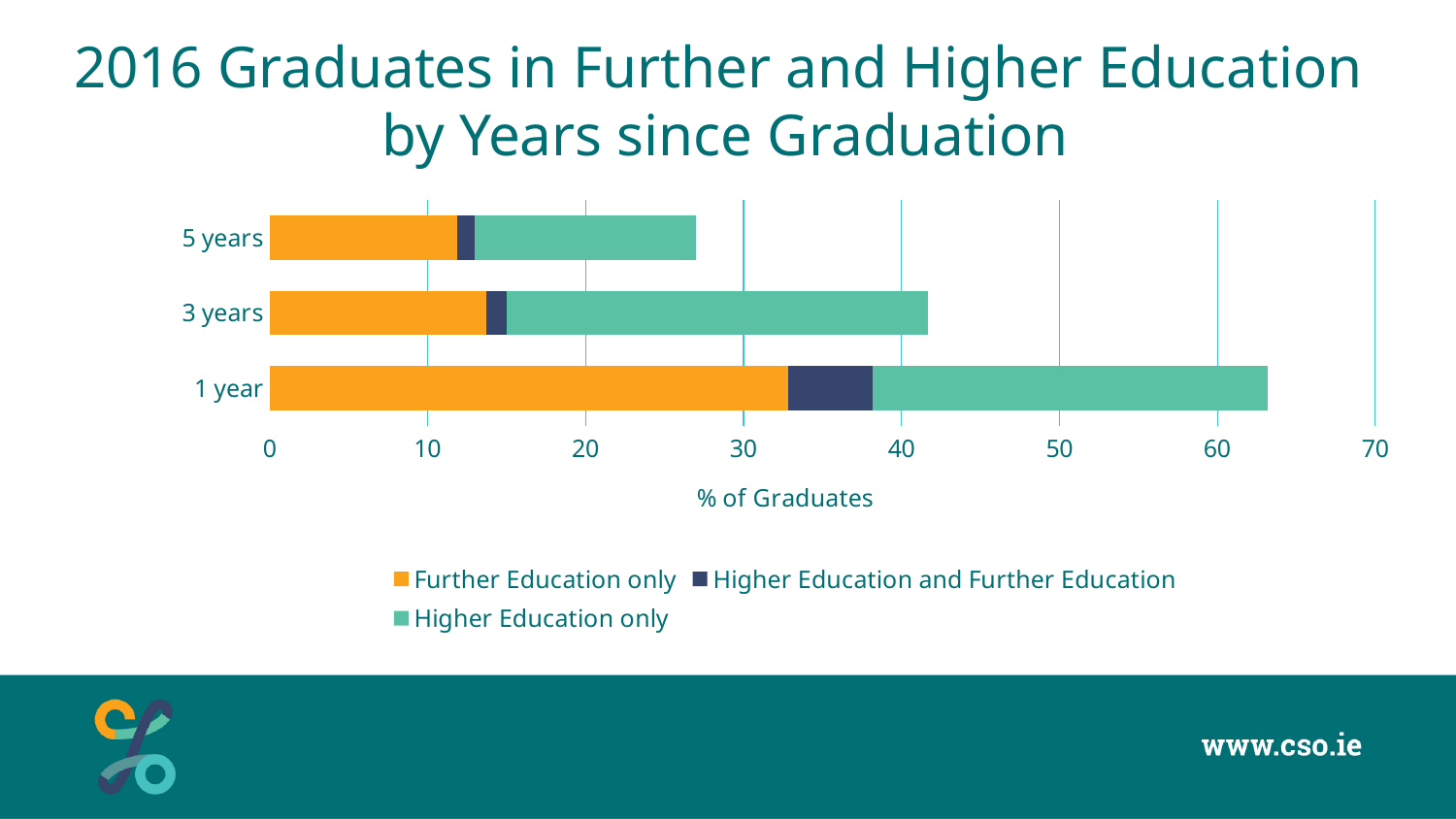
Which category has the longest total bar? 1 year Is the total value for 1 year greater or less than 60? greater Is the Further Education only value for 5 years greater or less than 10? greater What is the label on the horizontal axis? % of Graduates Is the Further Education only value for 1 year greater or less than 30? greater As the years since graduation increase from 1 year to 5 years, does the total percentage of graduates in education rise or fall? fall What kind of chart is shown on the slide? stacked bar chart Which category has the shortest total bar? 5 years How many series does the legend list? 3 How many categories (years since graduation) are shown on the chart? 3 Which is larger, the Further Education only value for 1 year or for 5 years? 1 year